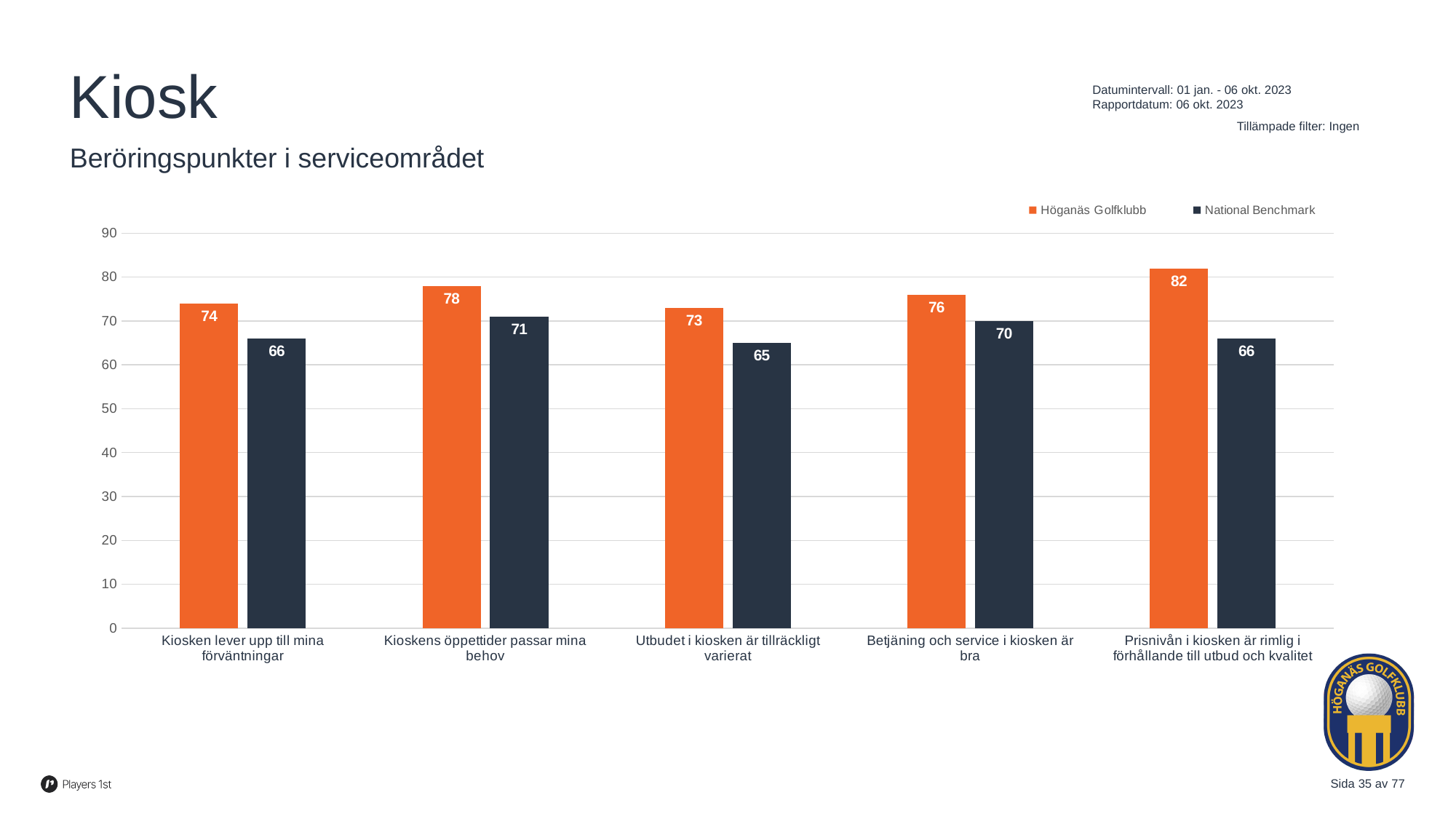
What kind of chart is shown on the slide? Bar chart Which series is shown in orange? Höganäs Golfklubb Is the National Benchmark value for "Betjäning och service i kiosken är bra" greater or less than 60? greater What is the difference between the Höganäs Golfklubb and National Benchmark values for "Prisnivån i kiosken är rimlig i förhållande till utbud och kvalitet"? 16 What is the Höganäs Golfklubb value for "Kiosken lever upp till mina förväntningar"? 74 How many categories are shown on the x axis? 5 For "Kioskens öppettider passar mina behov", which is larger: Höganäs Golfklubb or National Benchmark? Höganäs Golfklubb Which category has the highest Höganäs Golfklubb value? Prisnivån i kiosken är rimlig i förhållande till utbud och kvalitet How many series does the legend list? 2 What is the Höganäs Golfklubb value for "Prisnivån i kiosken är rimlig i förhållande till utbud och kvalitet"? 82 What is the National Benchmark value for "Utbudet i kiosken är tillräckligt varierat"? 65 Which category has the lowest National Benchmark value? Utbudet i kiosken är tillräckligt varierat